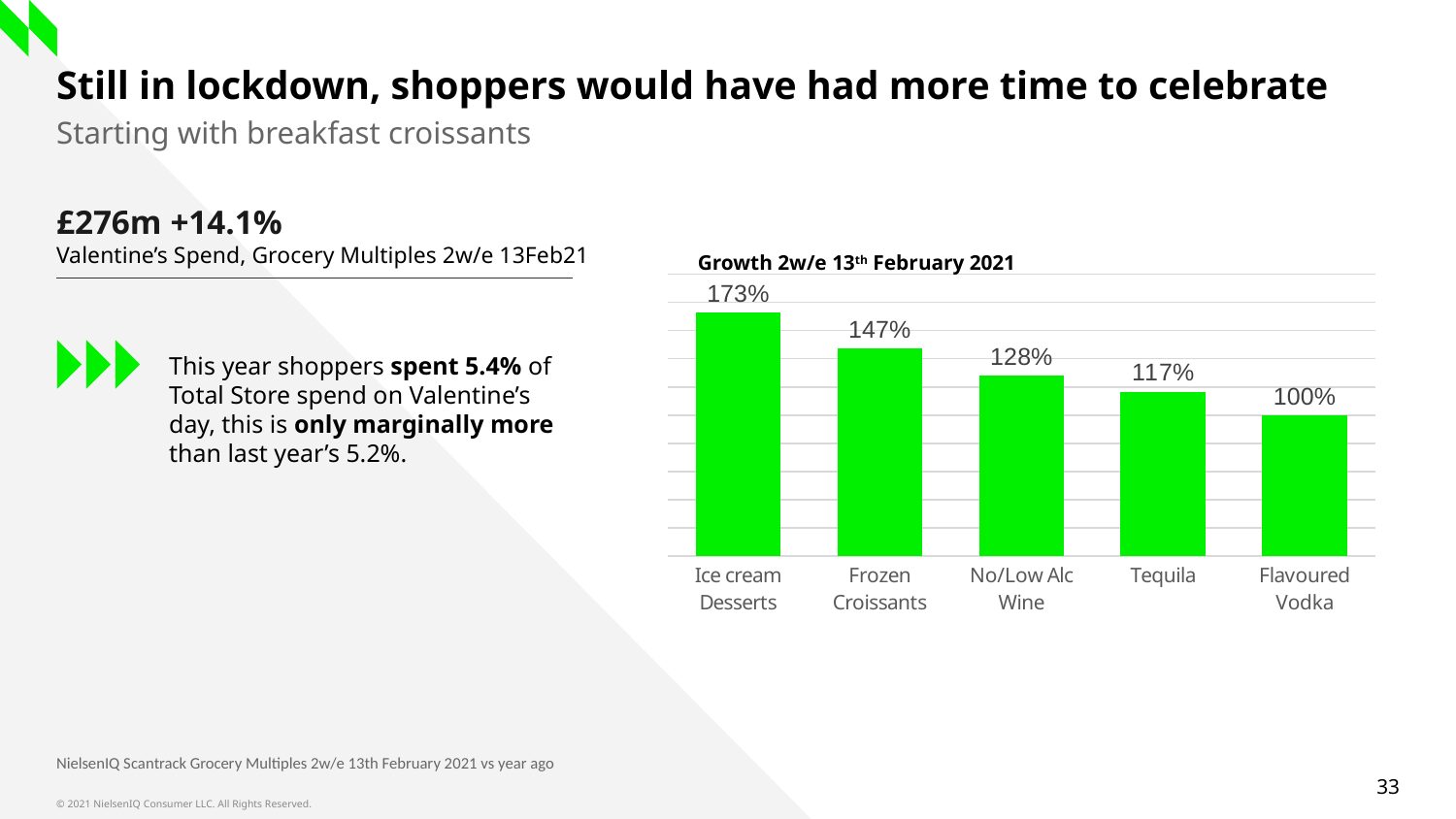
What is the difference in growth between Ice cream Desserts and Frozen Croissants? 26% Which category has the lowest growth? Flavoured Vodka Which has higher growth, Tequila or No/Low Alc Wine? No/Low Alc Wine What is the growth value for Ice cream Desserts? 173% What is the growth value for Flavoured Vodka? 100% What is the growth value for Frozen Croissants? 147% What is the growth value for No/Low Alc Wine? 128% What is the title of the chart? Growth 2w/e 13th February 2021 What kind of chart is shown on the slide? Bar chart What is the growth value for Tequila? 117% Which category has the highest growth? Ice cream Desserts How many categories are shown in the chart? 5